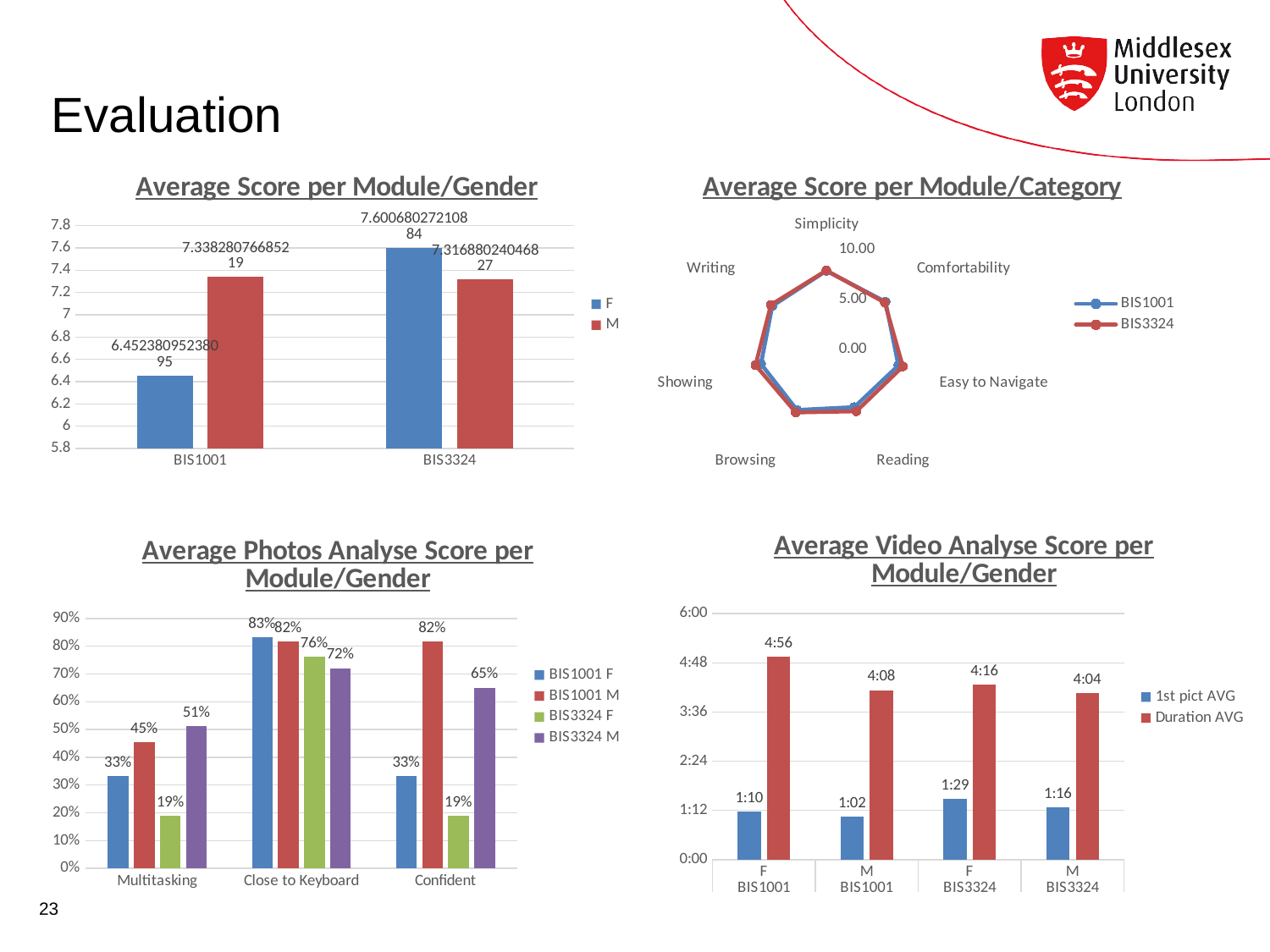
In the 'Average Score per Module/Gender' chart, is the F value for BIS1001 greater or less than 7? less Which two series does the legend of the 'Average Score per Module/Category' chart list? BIS1001 and BIS3324 In the 'Average Photos Analyse Score per Module/Gender' chart, what is the BIS3324 M value for Multitasking? 51% What kind of chart is 'Average Video Analyse Score per Module/Gender'? bar chart What kind of chart is 'Average Score per Module/Category'? radar chart How many series does the legend of the 'Average Score per Module/Gender' chart list? 2 In the 'Average Score per Module/Gender' chart, which module has the higher F value? BIS3324 How many categories are shown on the 'Average Score per Module/Category' chart? 7 In the 'Average Video Analyse Score per Module/Gender' chart, what is the Duration AVG for F BIS1001? 4:56 In the 'Average Photos Analyse Score per Module/Gender' chart, what is the difference between the BIS1001 M and BIS3324 M values for Confident? 17% In the 'Average Video Analyse Score per Module/Gender' chart, which category has the lowest 1st pict AVG? M BIS1001 In the 'Average Photos Analyse Score per Module/Gender' chart, which series has the highest value for Close to Keyboard? BIS1001 F